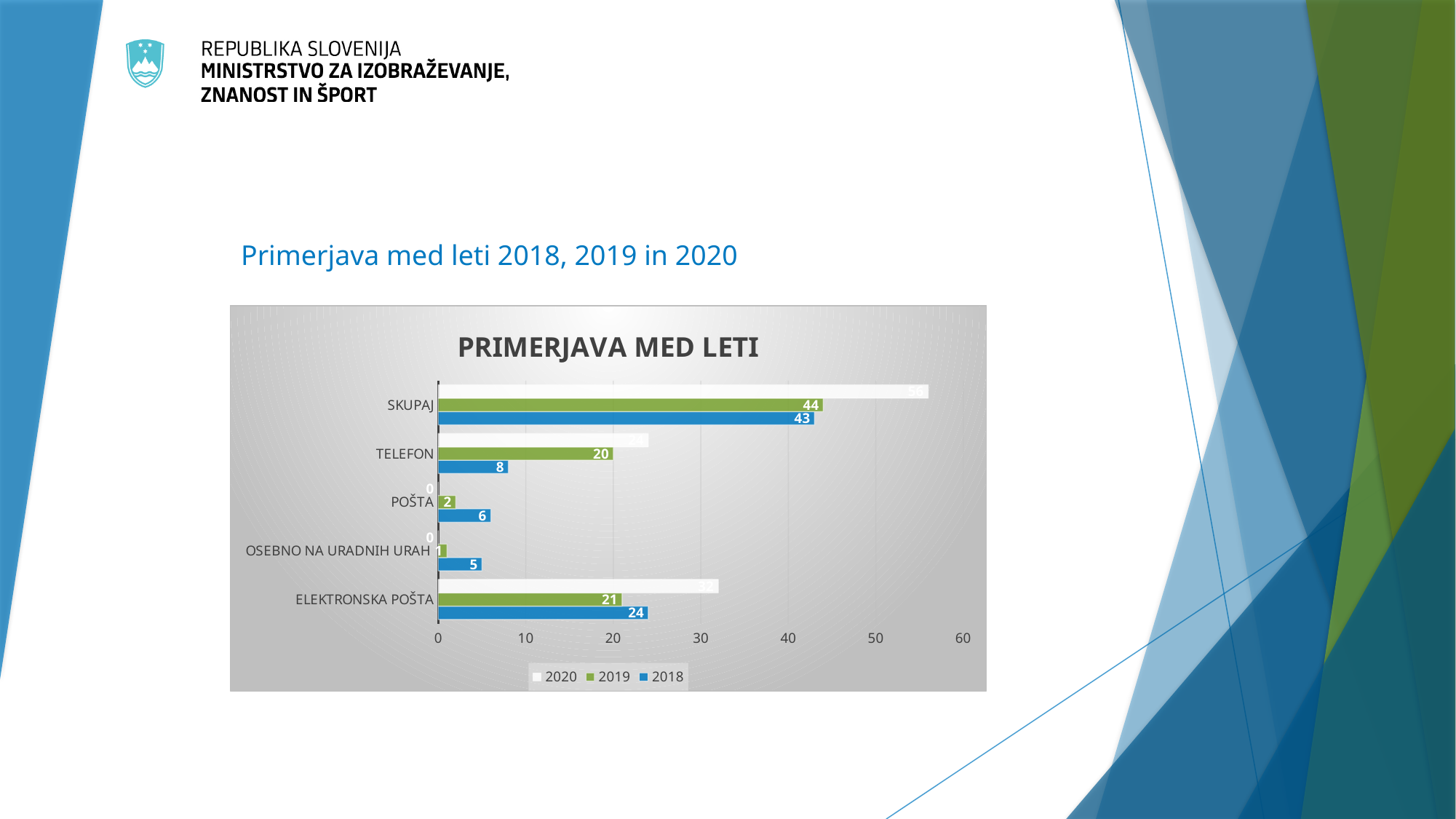
What is the value for TELEFON in 2019? 20 What is the value for ELEKTRONSKA POŠTA in 2018? 24 Is the 2020 value for TELEFON greater or less than 20? greater What kind of chart is shown on the slide? bar chart How many categories are shown on the chart? 5 What is the value for POŠTA in 2018? 6 Which category has the highest value for 2018? SKUPAJ For ELEKTRONSKA POŠTA, which is larger: the 2018 value or the 2019 value? 2018 What is the difference between the 2020 and 2019 values for SKUPAJ? 12 Which category has the lowest value for 2018? OSEBNO NA URADNIH URAH How many series does the legend of the chart list? 3 What is the value for SKUPAJ in 2020? 56